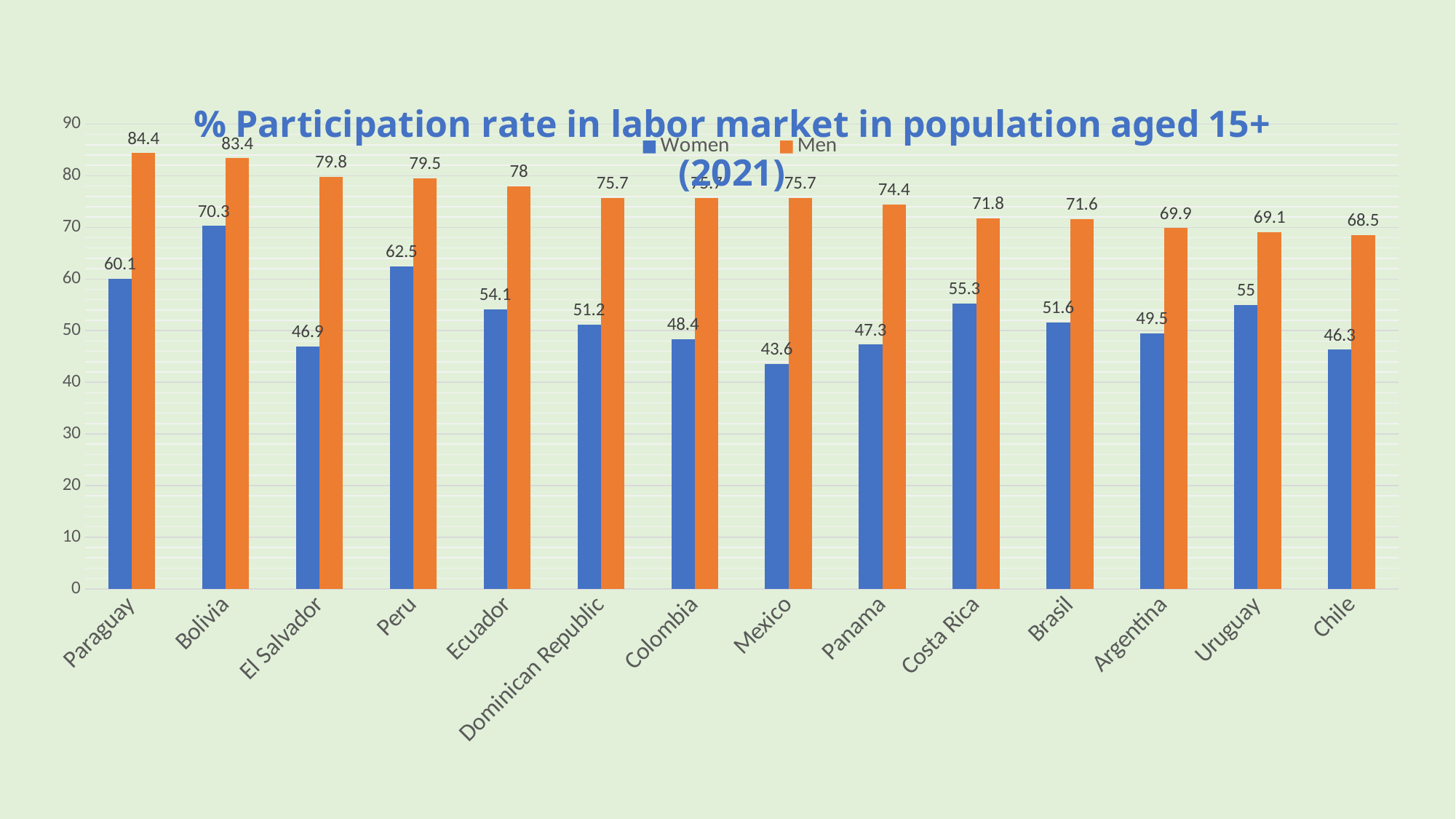
Which country has the highest participation rate for men? Paraguay Which is larger, the women's participation rate in Peru or in Costa Rica? Peru What is the participation rate for women in Uruguay? 55 Which country has the lowest participation rate for women? Mexico Do the men's participation rates generally rise or fall from left to right across the countries? Fall How many series does the legend list? 2 What kind of chart is shown on the slide? Bar chart What is the labor market participation rate for women in Bolivia? 70.3 Which country has the highest participation rate for women? Bolivia What is the labor market participation rate for men in Chile? 68.5 What is the difference between the men's and women's participation rates in Paraguay? 24.3 How many countries are shown on the chart? 14